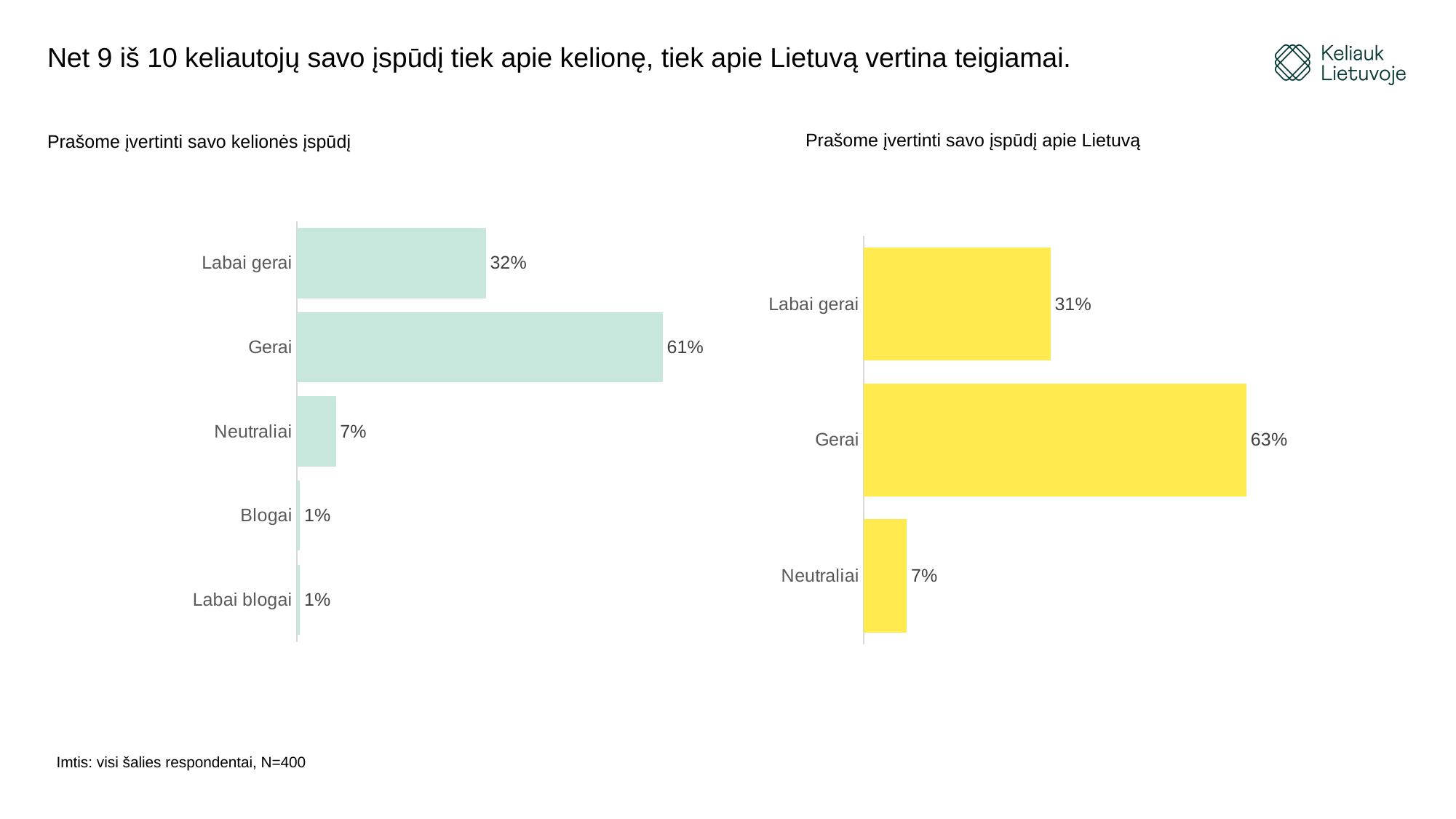
In the left chart 'Prašome įvertinti savo kelionės įspūdį', what is the difference between Gerai and Labai gerai? 29 percentage points In the right chart 'Prašome įvertinti savo įspūdį apie Lietuvą', which category has the lowest value? Neutraliai What type of chart is the right chart 'Prašome įvertinti savo įspūdį apie Lietuvą'? Bar chart In the right chart 'Prašome įvertinti savo įspūdį apie Lietuvą', what is the value for Gerai? 63% In the left chart 'Prašome įvertinti savo kelionės įspūdį', which category has the highest value? Gerai In the left chart 'Prašome įvertinti savo kelionės įspūdį', what is the value for Labai gerai? 32% Which is larger: Labai gerai in the left chart or Labai gerai in the right chart? Labai gerai in the left chart (32%) In the right chart 'Prašome įvertinti savo įspūdį apie Lietuvą', what is the difference between Gerai and Labai gerai? 32 percentage points In the left chart 'Prašome įvertinti savo kelionės įspūdį', what is the value for Gerai? 61% How many categories does the left chart 'Prašome įvertinti savo kelionės įspūdį' show? 5 In the right chart 'Prašome įvertinti savo įspūdį apie Lietuvą', what is the value for Neutraliai? 7% How many categories does the right chart 'Prašome įvertinti savo įspūdį apie Lietuvą' show? 3